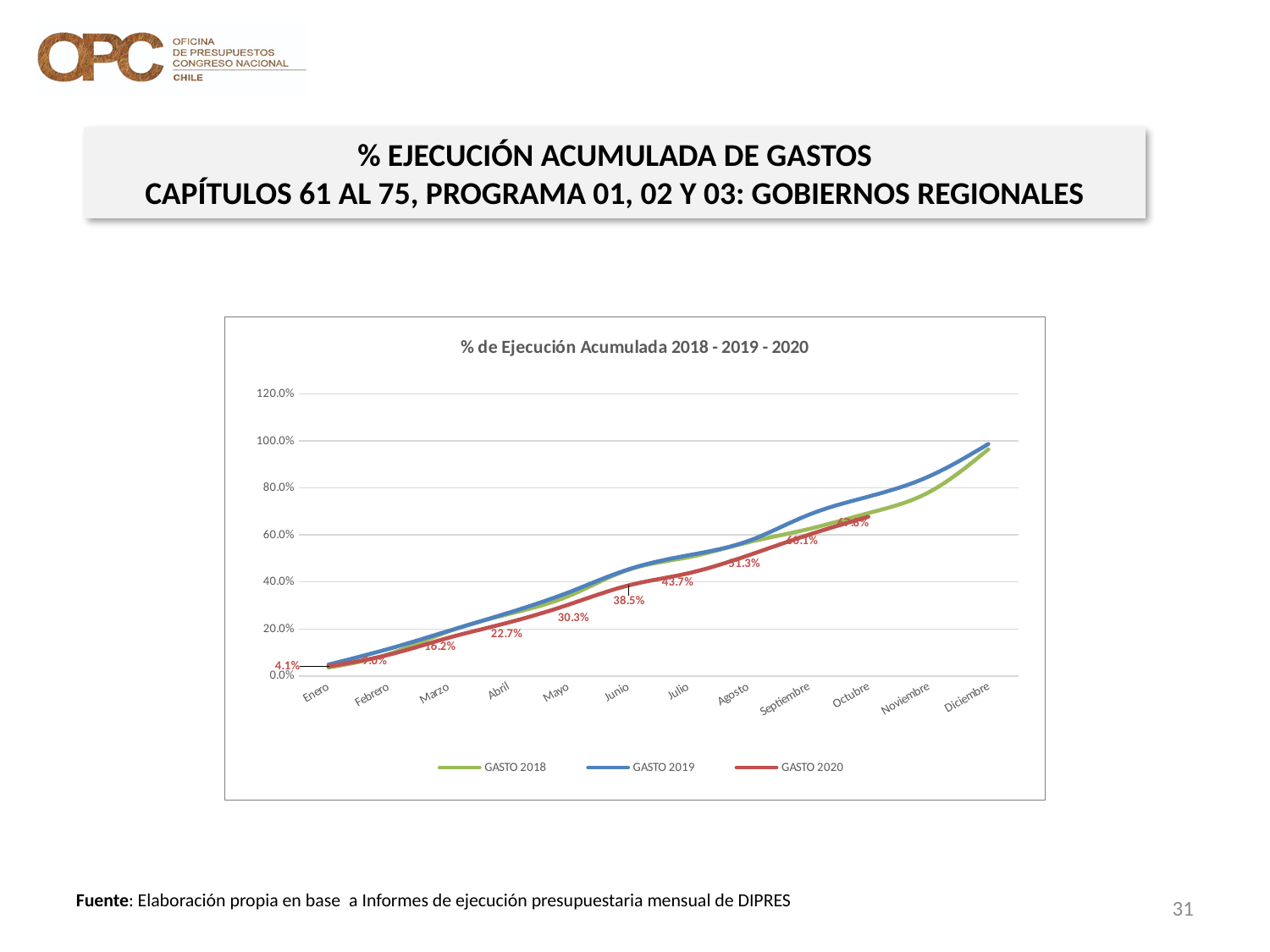
In Septiembre, which is larger: GASTO 2019 or GASTO 2020? GASTO 2019 What kind of chart is shown on the slide? line chart What is the value for GASTO 2020 in Enero? 4.1% By how many percentage points does GASTO 2020 increase from Julio to Agosto? 7.6 How many series does the chart legend list? 3 Do the GASTO 2019 values rise or fall from Enero to Diciembre? rise What is the value for GASTO 2020 in Marzo? 16.2% What is the title of the chart? % de Ejecución Acumulada 2018 - 2019 - 2020 What is the value for GASTO 2020 in Junio? 38.5% Is the value for GASTO 2019 in Diciembre greater or less than 80.0%? greater How many months are shown along the x axis of the chart? 12 What is the value for GASTO 2020 in Septiembre? 60.1%